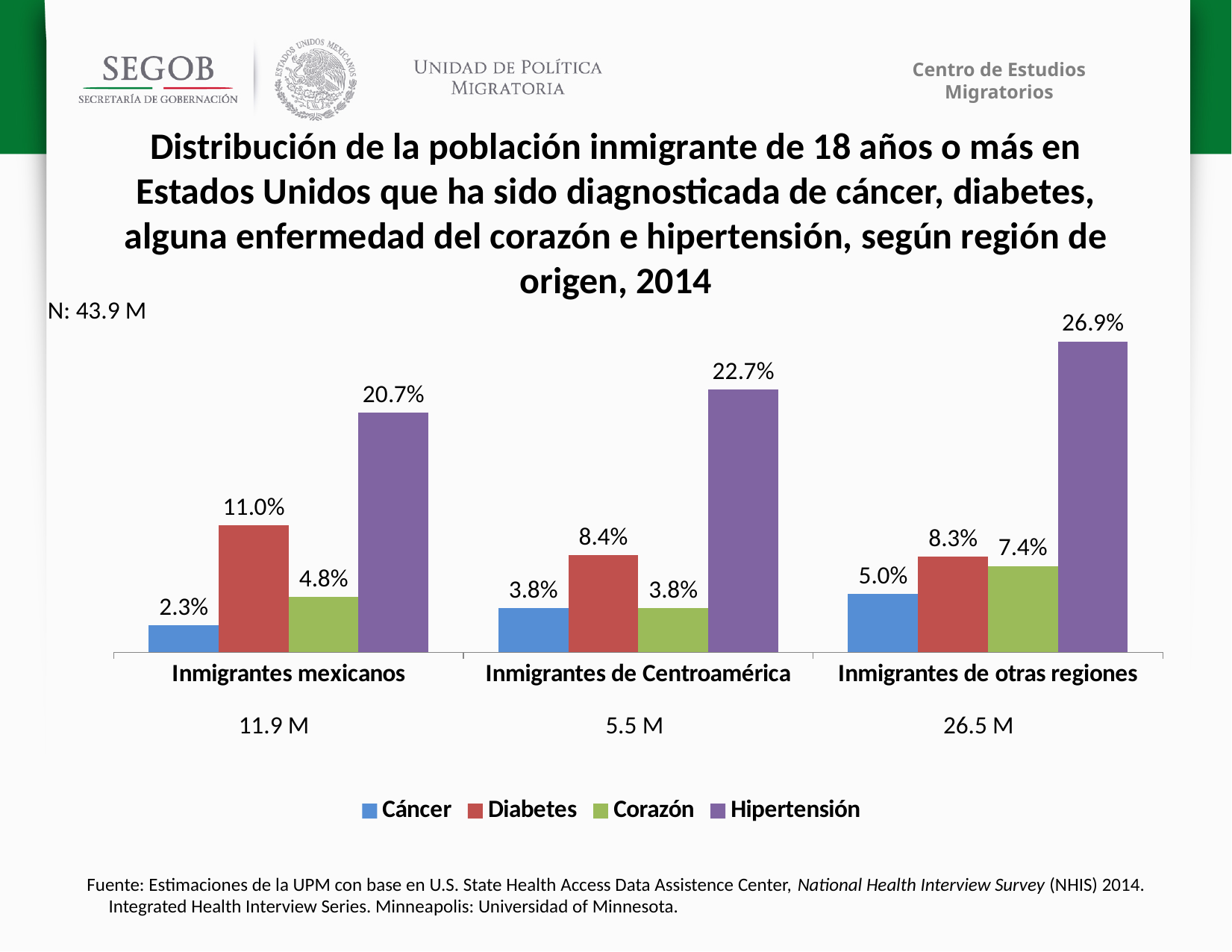
Which region has the highest Hipertensión value? Inmigrantes de otras regiones What kind of chart is shown on the slide? Bar chart How many regions (categories) are shown on the x axis? 3 Which colour represents Hipertensión in the legend? Purple Which region has the lowest Cáncer value? Inmigrantes mexicanos How many series does the legend list? 4 Which is larger: the Diabetes value for Inmigrantes mexicanos or for Inmigrantes de Centroamérica? Inmigrantes mexicanos What is the Corazón value for Inmigrantes mexicanos? 4.8% What is the Diabetes value for Inmigrantes de Centroamérica? 8.4% What is the Cáncer value for Inmigrantes de otras regiones? 5.0% What is the Hipertensión value for Inmigrantes mexicanos? 20.7% What is the difference between the Hipertensión values for Inmigrantes de otras regiones and Inmigrantes mexicanos? 6.2%